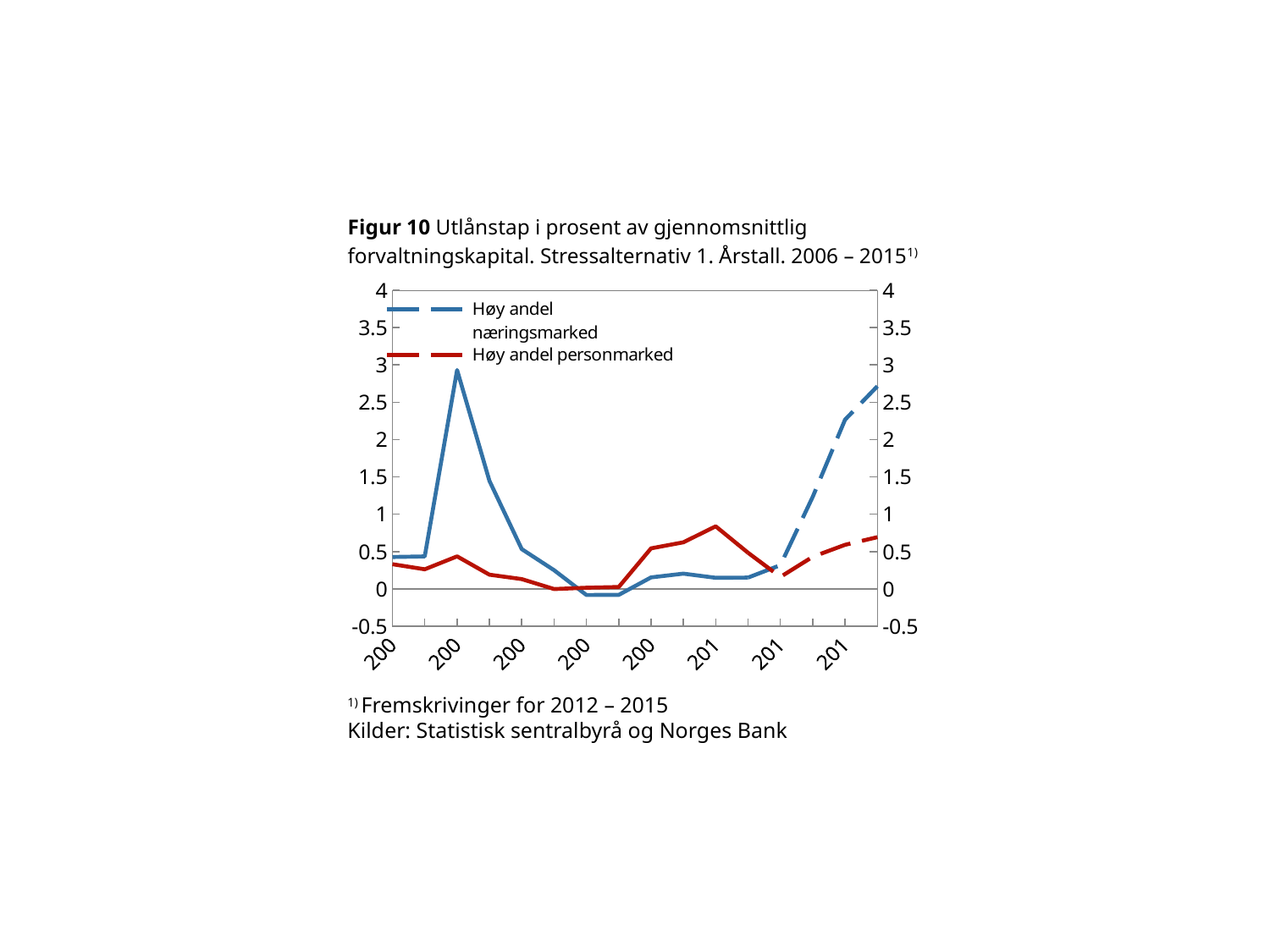
Is the final (2015) value of Høy andel næringsmarked greater or less than 2? greater Over the dashed projection period, does the Høy andel næringsmarked line rise or fall? rise What kind of chart is shown in Figur 10? Line chart Is the final (2015) value of Høy andel personmarked greater or less than 1? less How many series does the legend of Figur 10 list? 2 What are the two series named in the legend of Figur 10? Høy andel næringsmarked and Høy andel personmarked What is the highest value shown on the y axis of Figur 10? 4 Is the highest value of Høy andel personmarked greater or less than 1? less According to the footnote, which years are projections (fremskrivinger) in Figur 10? 2012 – 2015 What is the lowest value shown on the y axis of Figur 10? -0.5 Which series reaches the higher peak in Figur 10, Høy andel næringsmarked or Høy andel personmarked? Høy andel næringsmarked